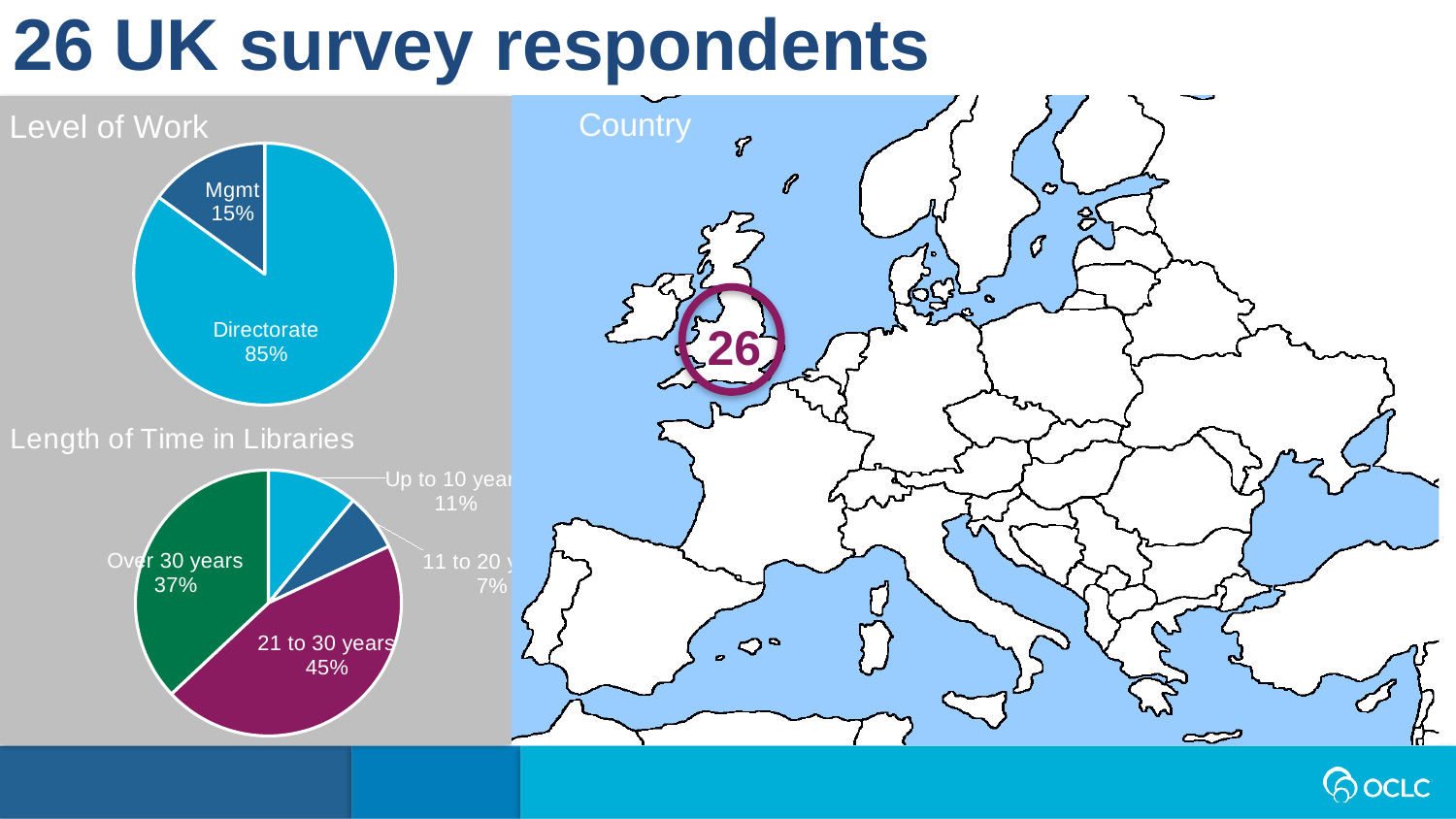
In the Length of Time in Libraries chart, what share of respondents have 21 to 30 years? 45% In the Length of Time in Libraries chart, what is the combined share of 21 to 30 years and Over 30 years? 82% In the Level of Work chart, what share of respondents are Directorate? 85% In the Level of Work chart, what is the difference between the Directorate and Mgmt shares? 70 percentage points What kind of chart is the Level of Work chart? Pie chart In the Length of Time in Libraries chart, which is larger: Up to 10 years or 11 to 20 years? Up to 10 years In the Length of Time in Libraries chart, which category has the largest share? 21 to 30 years In the Length of Time in Libraries chart, what share of respondents have over 30 years? 37% In the Length of Time in Libraries chart, which category has the smallest share? 11 to 20 years How many slices does the Length of Time in Libraries pie chart have? 4 In the Level of Work chart, what share of respondents are Mgmt? 15% How many slices does the Level of Work pie chart have? 2